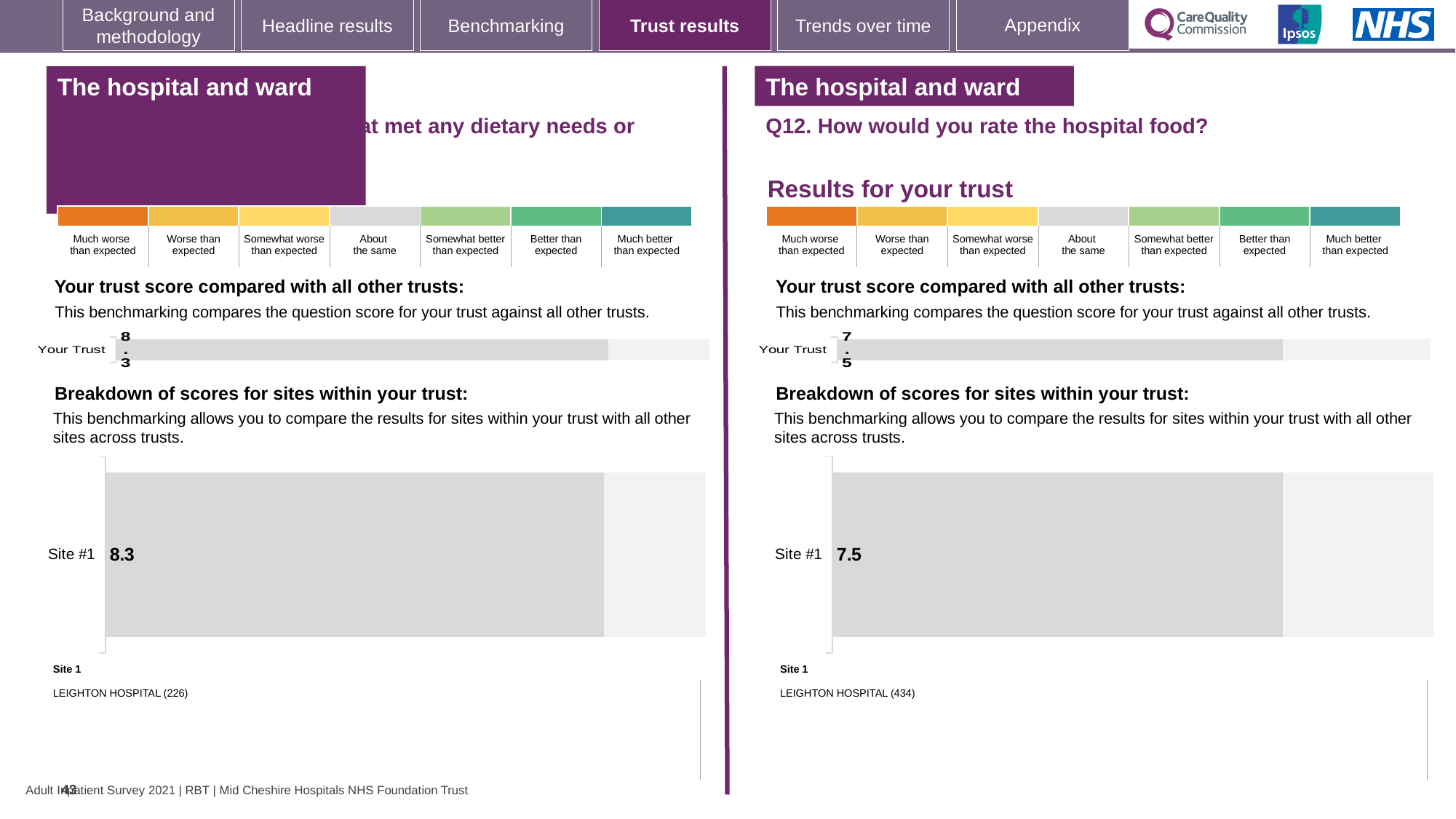
Comparing the Site #1 scores in the two site breakdown charts, which is larger: the left chart or the right (Q12) chart? the left chart (8.3) In the Q12 'Your trust score compared with all other trusts' chart, what is the label of the single bar plotted? Your Trust In the 'Your trust score compared with all other trusts' chart for Q12 (right half of the slide), what is the score for Your Trust? 7.5 How many sites are plotted in the 'Breakdown of scores for sites within your trust' chart on the left half of the slide? 1 In the colour scale above the Q12 charts, what colour is the 'Much worse than expected' category? orange What kind of chart is the 'Your trust score compared with all other trusts' chart for Q12? bar chart In the 'Breakdown of scores for sites within your trust' chart on the left half of the slide, what is the score for Site #1? 8.3 What is the difference between the Site #1 score in the left breakdown chart (8.3) and the Site #1 score in the Q12 breakdown chart (7.5)? 0.8 How many sites are plotted in the 'Breakdown of scores for sites within your trust' chart for Q12 (right half of the slide)? 1 How many categories does the colour scale above the Q12 charts list, from 'Much worse than expected' to 'Much better than expected'? 7 In the 'Your trust score compared with all other trusts' chart on the left half of the slide, what is the score for Your Trust? 8.3 In the 'Breakdown of scores for sites within your trust' chart for Q12 (right half of the slide), what is the score for Site #1? 7.5